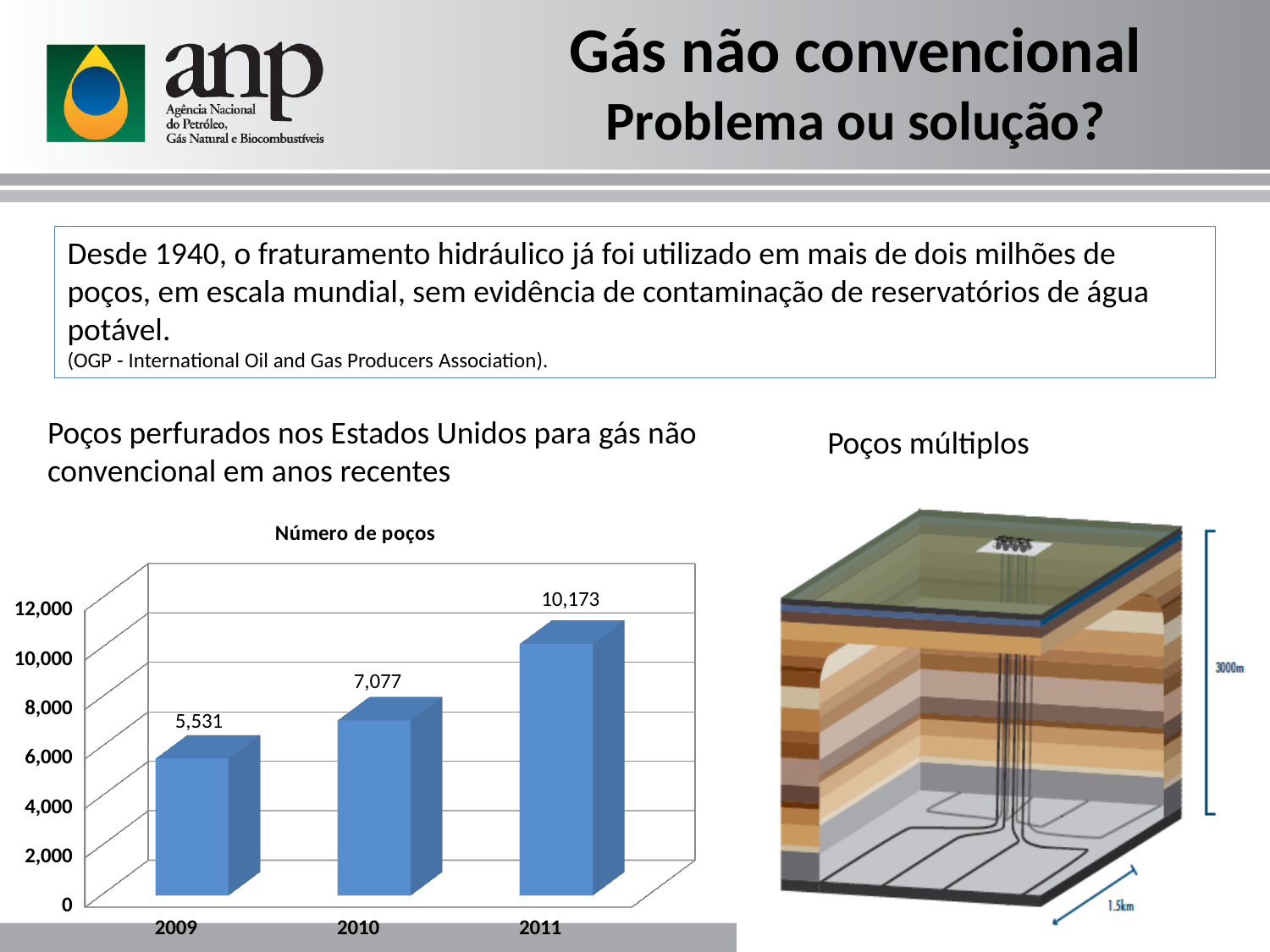
Do the values rise or fall from 2009 to 2011? rise Which year has the highest number of wells? 2011 Which year has the lowest number of wells? 2009 Is the value for 2011 greater or less than 10,000? greater What is the number of wells shown for 2011? 10,173 What is the difference in the number of wells between 2011 and 2010? 3,096 What is the number of wells (Número de poços) shown for 2009? 5,531 What is the difference in the number of wells between 2010 and 2009? 1,546 What is the number of wells shown for 2010? 7,077 What kind of chart is used to show the number of wells? bar chart Which year has more wells, 2009 or 2010? 2010 How many years are shown on the x axis of the chart? 3